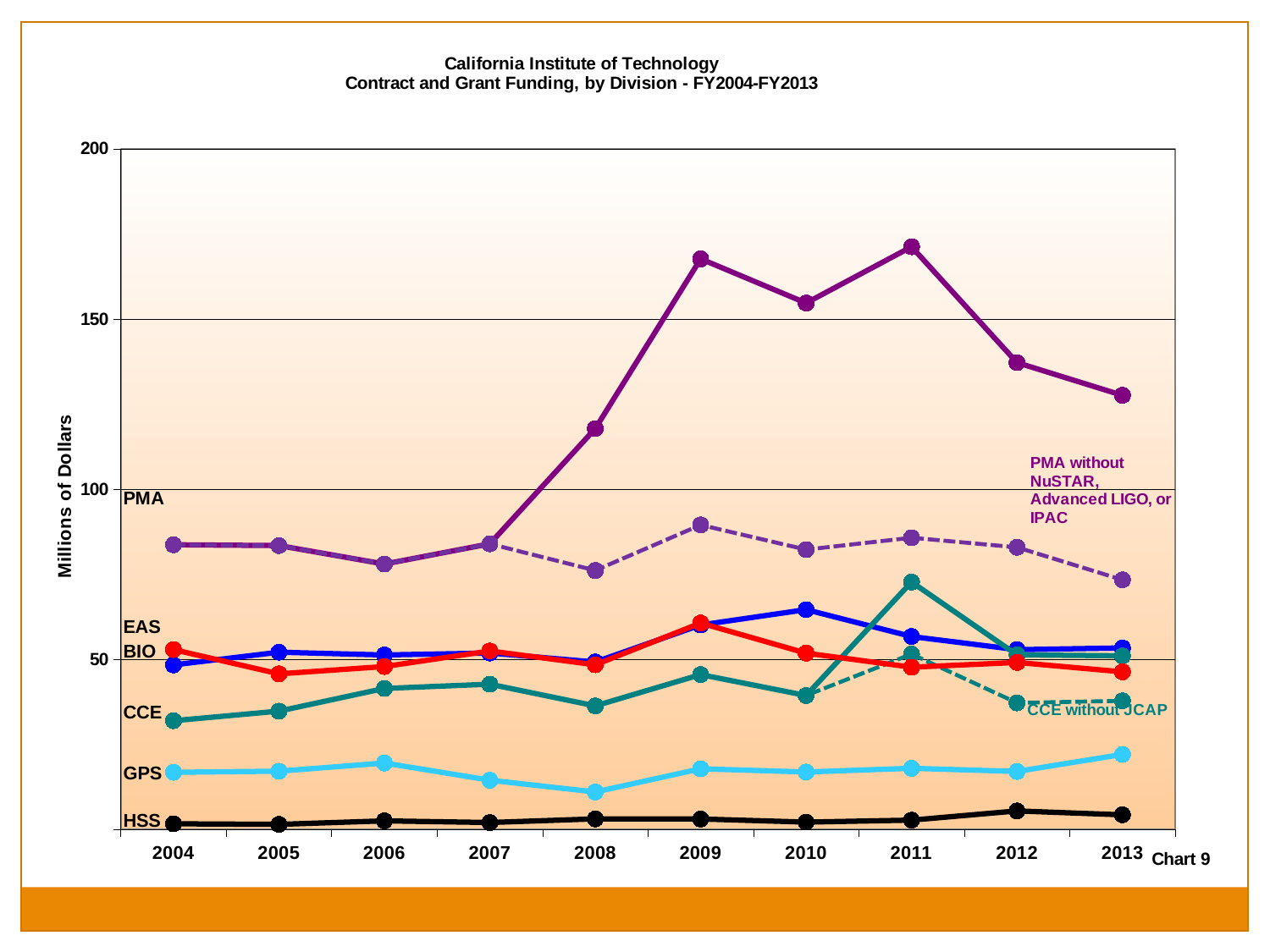
Is the value for PMA in 2004 greater or less than 100? less Which division has the highest funding in 2011? PMA Which is larger, the PMA value in 2009 or the PMA value in 2010? 2009 What kind of chart is shown on the slide? line chart Which division has the lowest funding in every year shown? HSS Does the PMA line rise or fall from 2011 to 2013? fall In which year does the PMA line reach its highest point? 2011 Is the value for CCE in 2011 greater or less than 50? greater Is the value for PMA in 2011 greater or less than 150? greater How many divisions are labeled at the left edge of the plot area? 6 How many fiscal years are plotted along the x axis? 10 What is the label on the y axis? Millions of Dollars